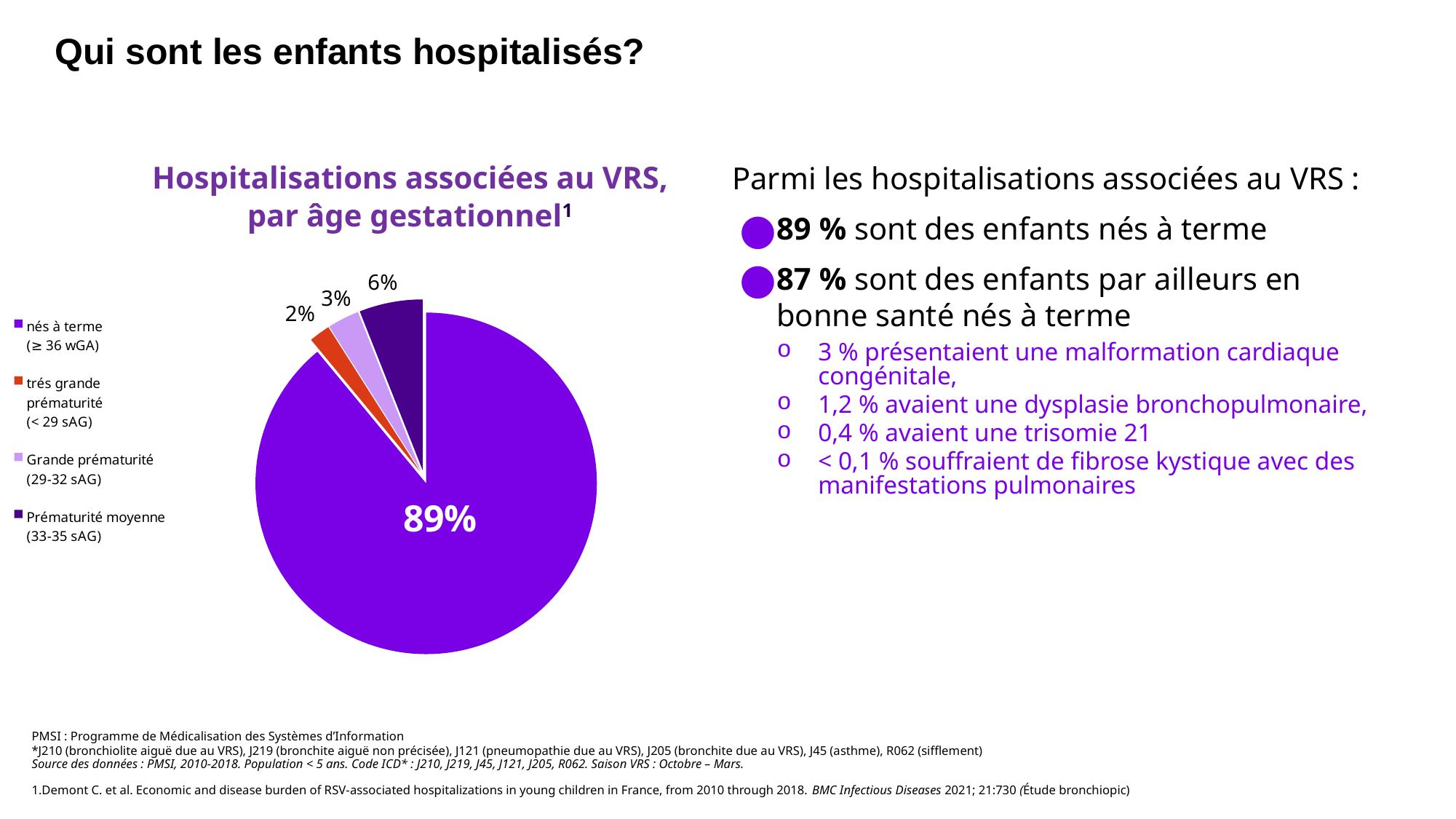
How many categories does the pie chart show? 4 What share of the pie corresponds to trés grande prématurité (< 29 sAG)? 2% What type of chart is shown on the slide? pie chart What is the title of the pie chart? Hospitalisations associées au VRS, par âge gestationnel What share of RSV-associated hospitalisations is for children born at term (nés à terme, ≥ 36 wGA)? 89% What share of the pie corresponds to Grande prématurité (29-32 sAG)? 3% What share of the pie corresponds to Prématurité moyenne (33-35 sAG)? 6% Which category has the smallest slice of the pie? trés grande prématurité (< 29 sAG) What colour is the slice for nés à terme (≥ 36 wGA)? purple Which slice is larger: Prématurité moyenne (33-35 sAG) or Grande prématurité (29-32 sAG)? Prématurité moyenne (33-35 sAG) Which category has the largest slice of the pie? nés à terme (≥ 36 wGA) What is the difference in percentage points between the Prématurité moyenne slice and the Grande prématurité slice? 3